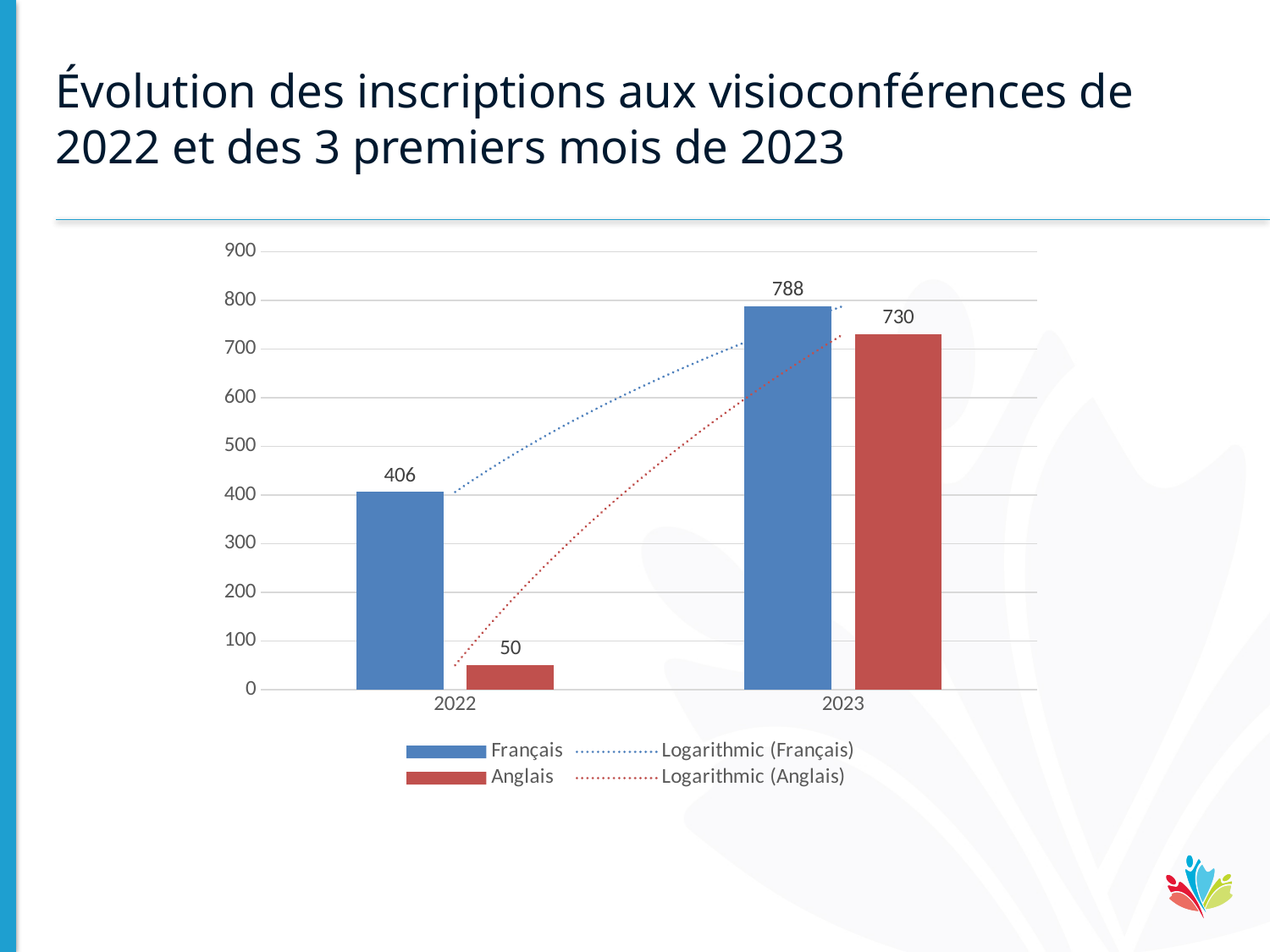
What is the value for Anglais in 2022? 50 What is the difference between the Anglais values for 2023 and 2022? 680 What is the value for Français in 2023? 788 What is the value for Anglais in 2023? 730 What is the value for Français in 2022? 406 How many entries does the legend list? 4 What kind of chart is shown on the slide? Bar chart Do the Anglais values rise or fall from 2022 to 2023? Rise Which is larger in 2022, Français or Anglais? Français What is the difference between Français and Anglais in 2023? 58 Which series has the lowest value in 2022? Anglais How many years are shown on the x axis? 2